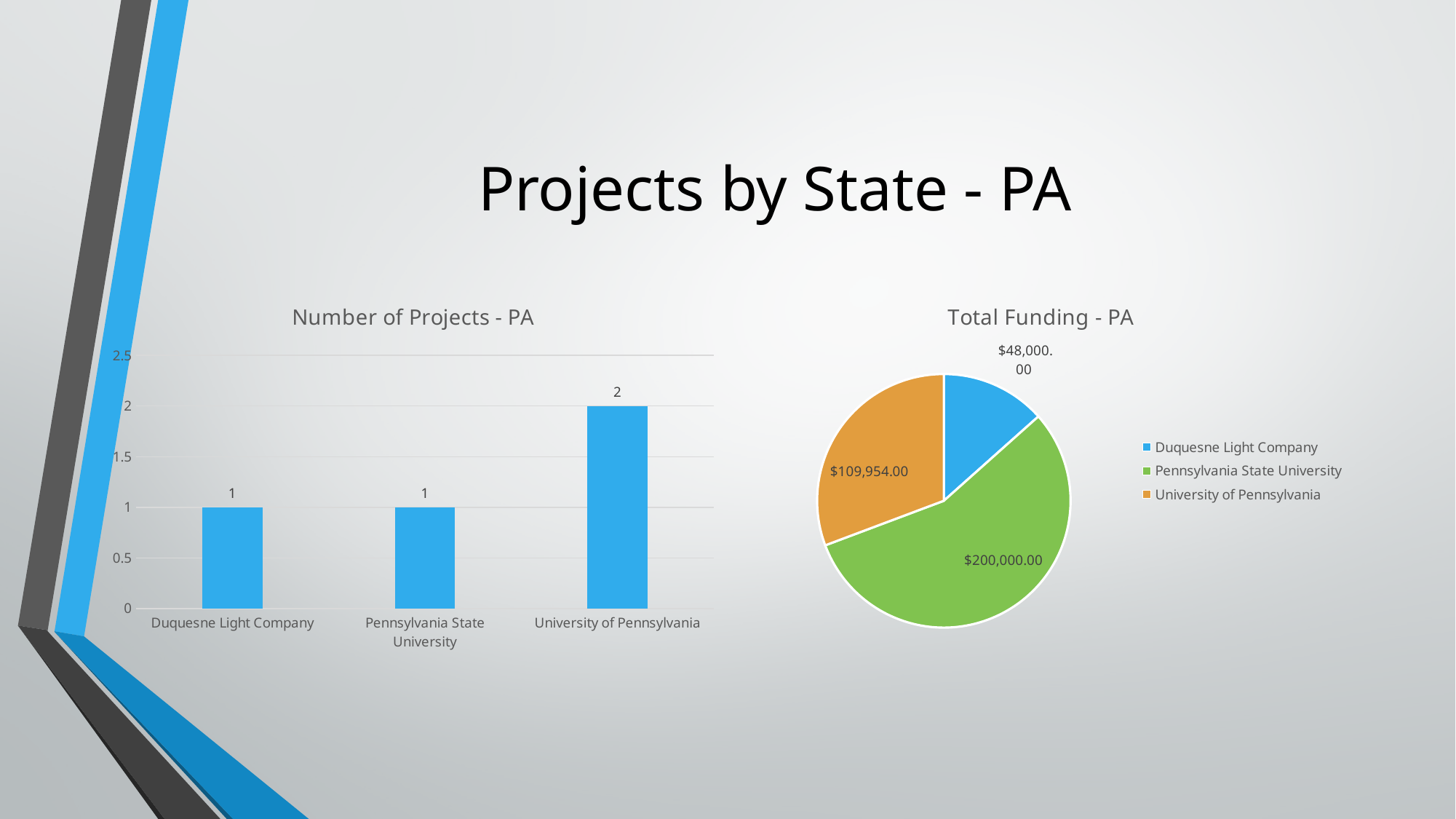
In the 'Total Funding - PA' chart, what is the funding for Pennsylvania State University? $200,000.00 What kind of chart is 'Number of Projects - PA'? Bar chart In the 'Number of Projects - PA' chart, how many projects does University of Pennsylvania have? 2 In the 'Total Funding - PA' chart, what is the difference between the funding for Pennsylvania State University and Duquesne Light Company? $152,000.00 In the 'Total Funding - PA' chart, which organization has the smallest slice? Duquesne Light Company In the 'Number of Projects - PA' chart, what is the difference between the number of projects for University of Pennsylvania and Pennsylvania State University? 1 In the 'Total Funding - PA' chart, which is larger: the funding for University of Pennsylvania or for Duquesne Light Company? University of Pennsylvania In the 'Total Funding - PA' chart, what is the funding for Duquesne Light Company? $48,000.00 In the 'Number of Projects - PA' chart, which category has the highest number of projects? University of Pennsylvania In the 'Total Funding - PA' chart, how many entries does the legend list? 3 In the 'Number of Projects - PA' chart, how many projects does Duquesne Light Company have? 1 In the 'Number of Projects - PA' chart, how many categories are shown on the x axis? 3